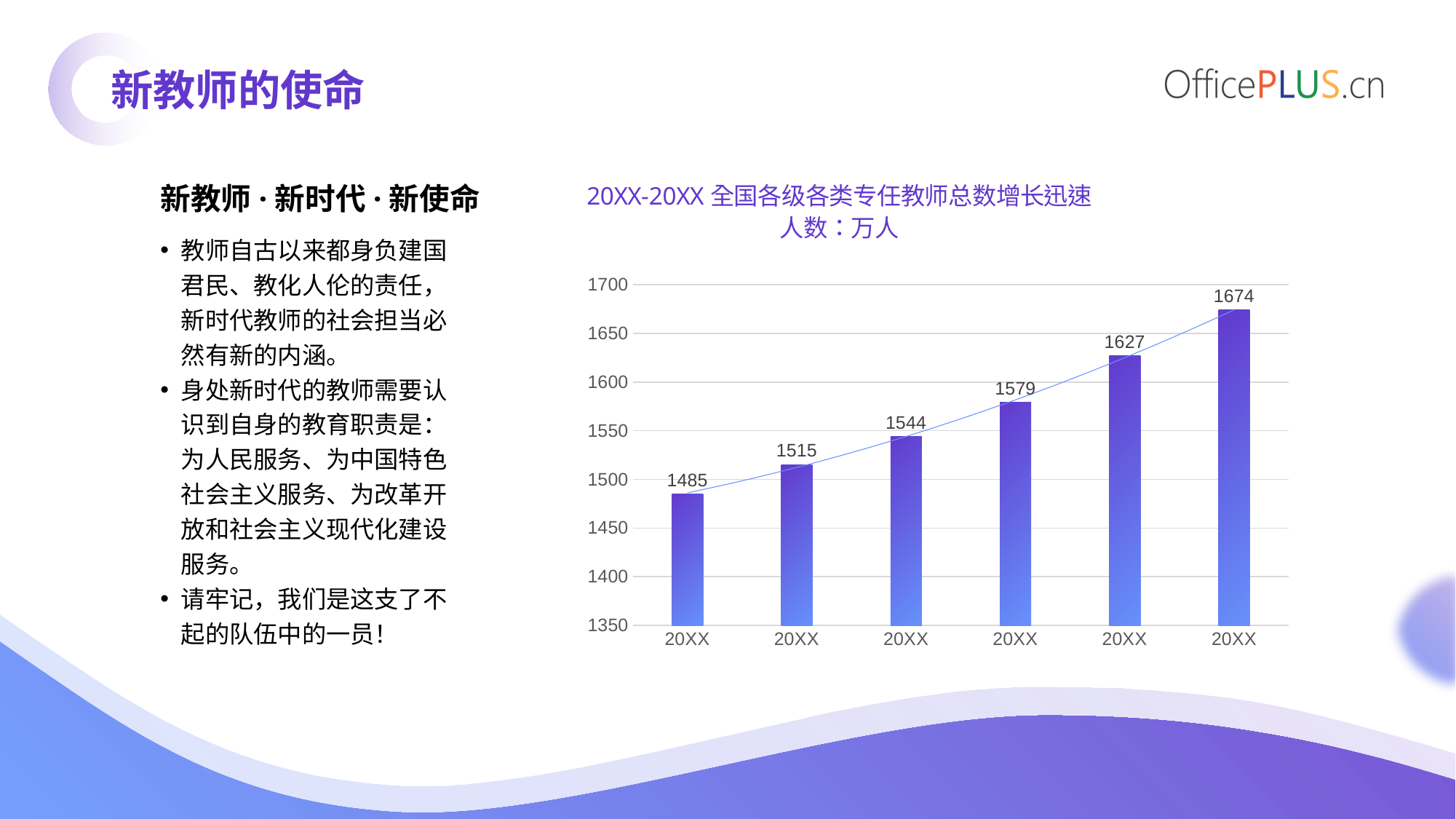
What type of chart is shown on the slide? bar chart How many bars are plotted in the chart? 6 What is the value of the third bar from the left in the chart? 1544 What is the value of the first (leftmost) bar in the chart? 1485 What is the highest value shown in the chart? 1674 What is the difference between the rightmost bar and the leftmost bar in the chart? 189 What is the lowest value shown in the chart? 1485 What unit is stated in the chart title for the plotted values? 万人 Do the values rise or fall from left to right along the x axis? rise What is the difference between the fifth bar (1627) and the fourth bar (1579) in the chart? 48 What is the value of the last (rightmost) bar in the chart? 1674 Which is larger, the second bar or the fourth bar in the chart? the fourth bar